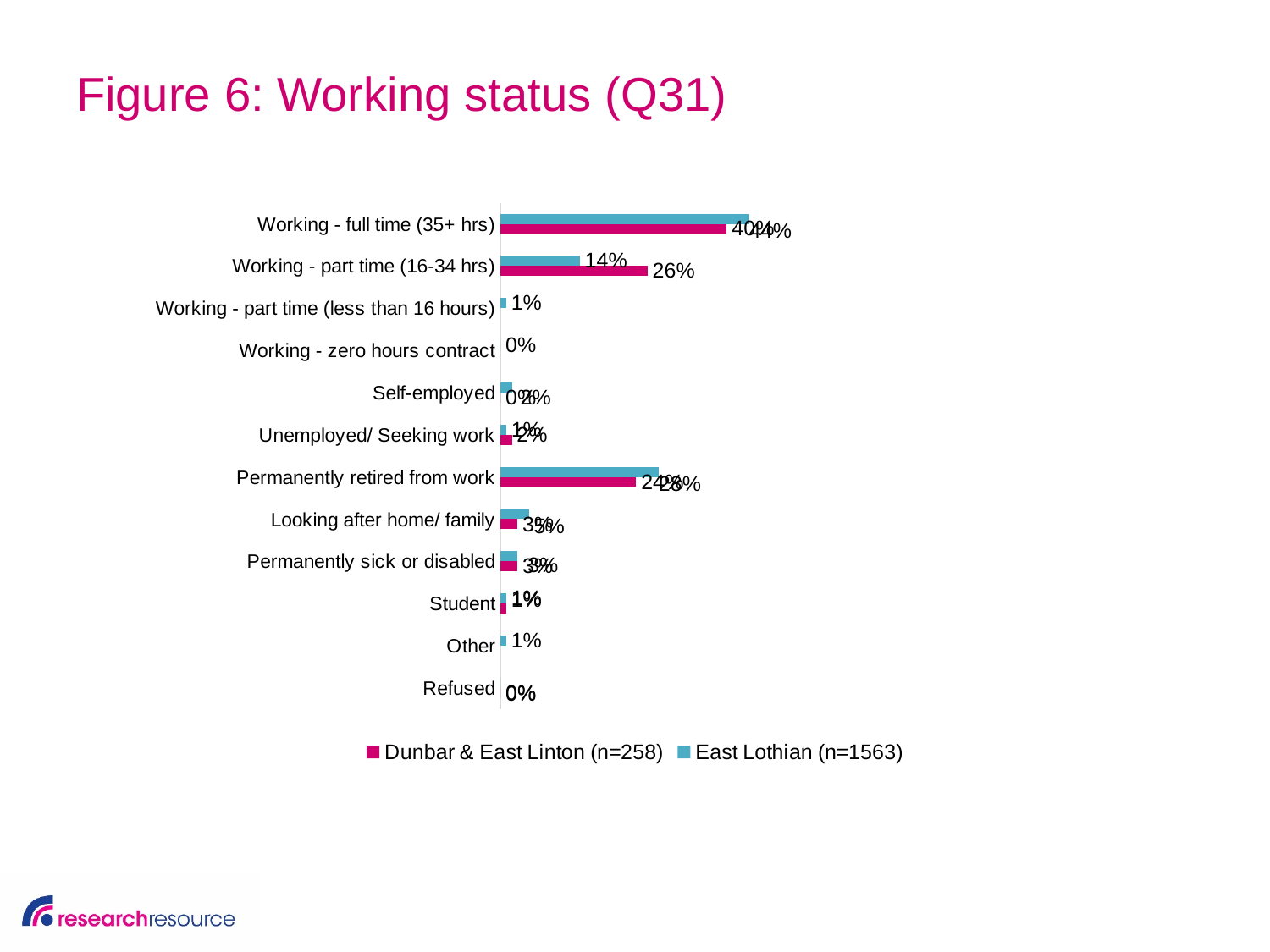
How many working status categories are shown on the chart? 12 Which category has the highest value for Dunbar & East Linton? Working - full time (35+ hrs) For 'Working - full time (35+ hrs)', which series has the larger value, Dunbar & East Linton or East Lothian? East Lothian For 'Working - part time (16-34 hrs)', which series has the larger value, Dunbar & East Linton or East Lothian? Dunbar & East Linton What is the value for Dunbar & East Linton for 'Working - part time (16-34 hrs)'? 26% How many series does the legend list? 2 What kind of chart is shown on the slide? Bar chart What is the value for East Lothian for 'Working - part time (16-34 hrs)'? 14% What value is shown for 'Working - zero hours contract'? 0% What is the sample size (n) for the Dunbar & East Linton series shown in the legend? 258 What is the difference between the Dunbar & East Linton and East Lothian values for 'Working - part time (16-34 hrs)'? 12 percentage points What is the title of the chart? Figure 6: Working status (Q31)